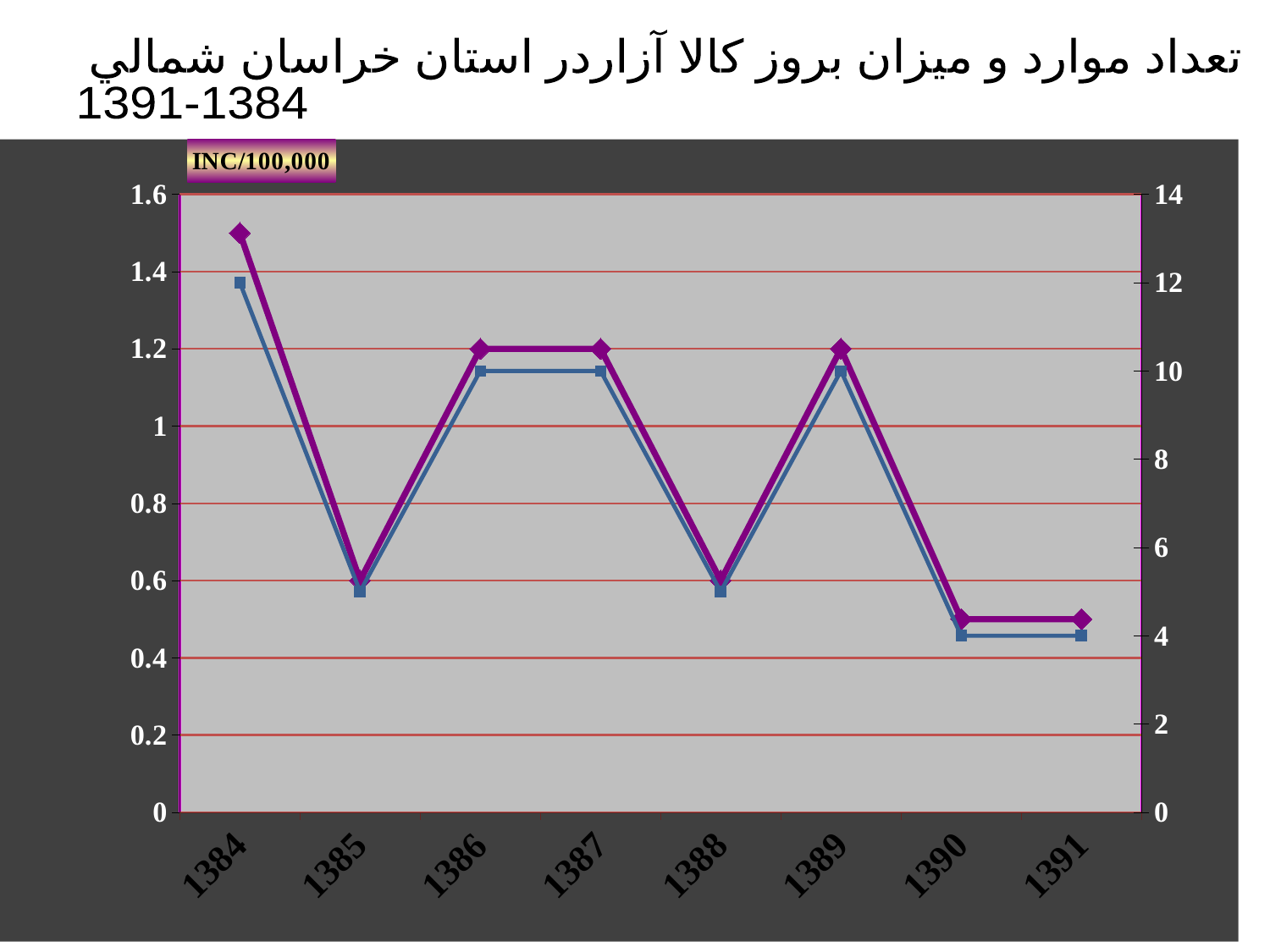
Is the value of the purple diamond-marker line for 1384 greater or less than 1.4 on the left axis? greater What label is shown in the box at the top left of the chart area? INC/100,000 What kind of chart is shown on the slide? line chart What is the value of the blue square-marker line (right axis) for 1384? 12 How many years are plotted along the x axis? 8 In which year does the purple diamond-marker line reach its highest value? 1384 What is the value of the purple diamond-marker line (left axis) for 1385? 0.6 For the purple diamond-marker line, which year has the larger value, 1384 or 1386? 1384 What is the difference between the purple diamond-marker line's values for 1386 and 1385 (left axis)? 0.6 What is the value of the purple diamond-marker line (left axis) for 1386? 1.2 Is the value of the blue square-marker line for 1390 greater or less than 6 on the right axis? less What is the value of the blue square-marker line (right axis) for 1389? 10